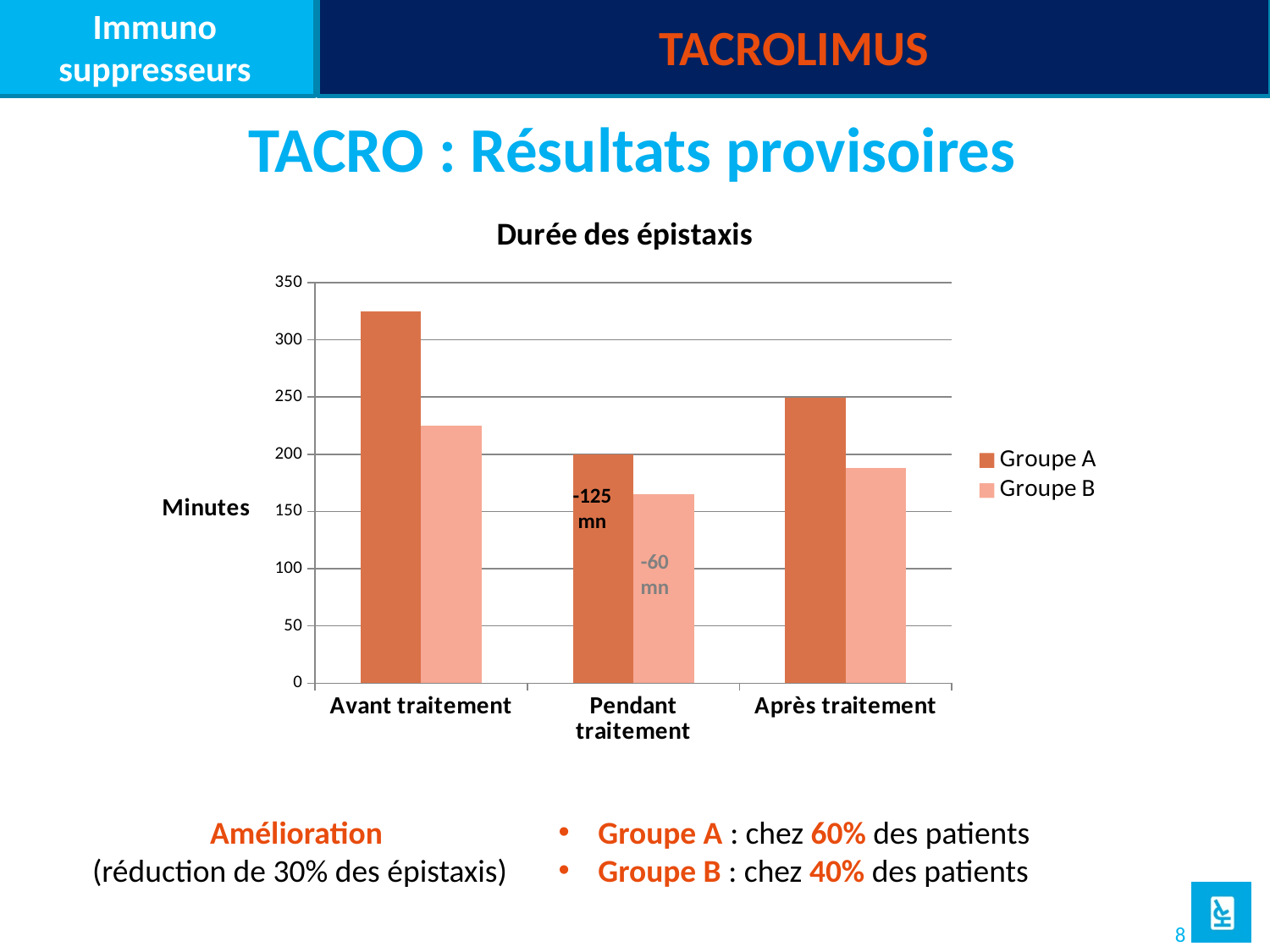
How many series does the legend of the "Durée des épistaxis" chart list? 2 What is the value for Groupe A in the "Pendant traitement" category? 200 What kind of chart is shown under the title "Durée des épistaxis"? bar chart In which category is the Groupe A value lowest? Pendant traitement Is the value for Groupe B in "Pendant traitement" greater or less than 150? greater In the "Avant traitement" category, which group has the larger value, Groupe A or Groupe B? Groupe A How many categories are shown on the x axis of the "Durée des épistaxis" chart? 3 Is the value for Groupe B in "Avant traitement" greater or less than 250? less Is the value for Groupe A in "Avant traitement" greater or less than 300? greater In which category is the Groupe A value highest? Avant traitement